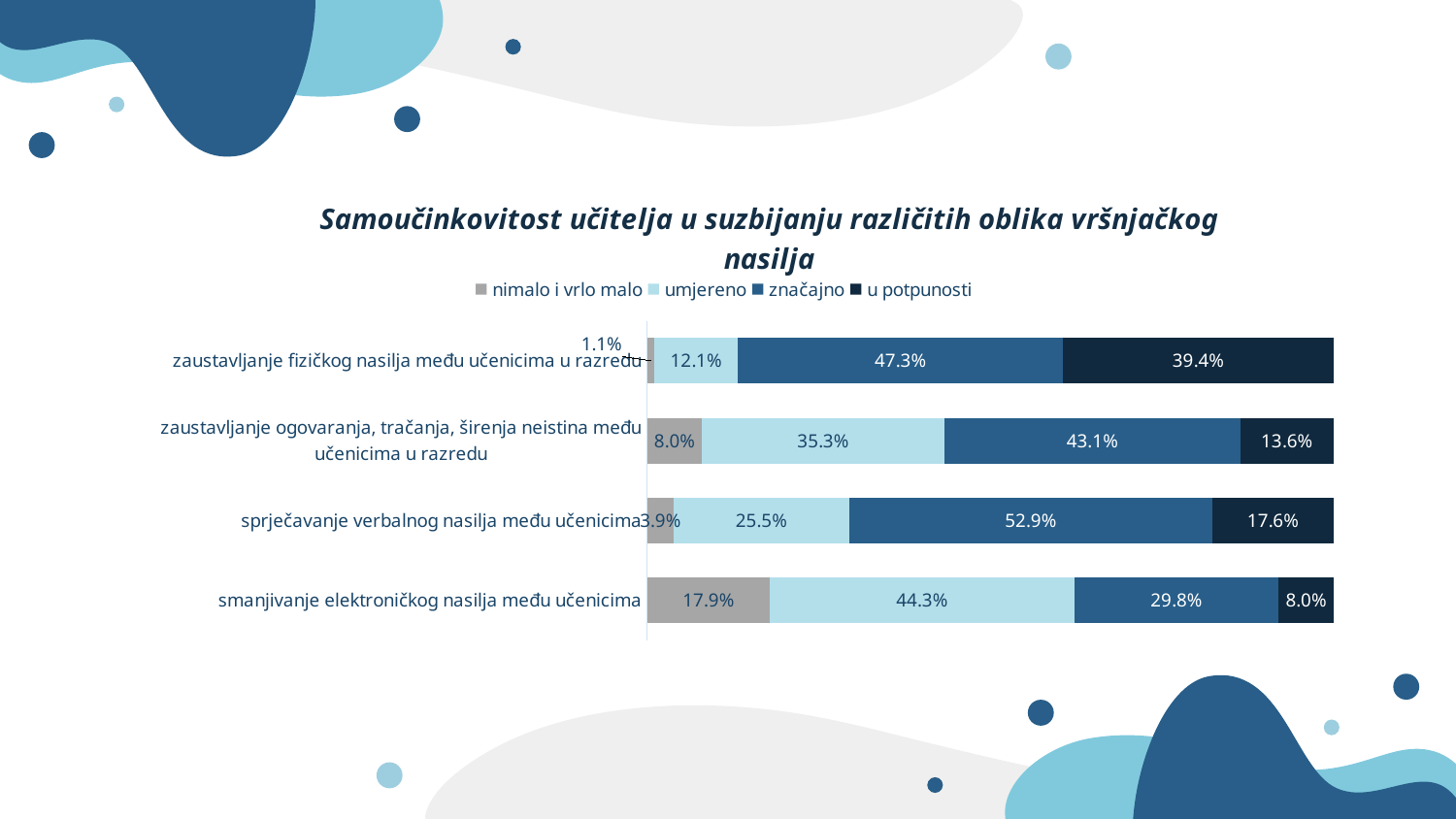
How many categories are plotted on the chart? 4 How many series does the legend list? 4 Which category has the highest 'značajno' value? sprječavanje verbalnog nasilja među učenicima What type of chart is shown on the slide? stacked bar chart Which category has the lowest 'u potpunosti' value? smanjivanje elektroničkog nasilja među učenicima What is the 'u potpunosti' value for 'zaustavljanje fizičkog nasilja među učenicima u razredu'? 39.4% What is the 'značajno' value for 'sprječavanje verbalnog nasilja među učenicima'? 52.9% Which is larger: the 'umjereno' value for 'zaustavljanje ogovaranja, tračanja, širenja neistina među učenicima u razredu' or for 'sprječavanje verbalnog nasilja među učenicima'? zaustavljanje ogovaranja, tračanja, širenja neistina među učenicima u razredu What is the difference between the 'u potpunosti' values for 'zaustavljanje fizičkog nasilja među učenicima u razredu' and 'sprječavanje verbalnog nasilja među učenicima'? 21.8% What is the 'umjereno' value for 'smanjivanje elektroničkog nasilja među učenicima'? 44.3% What is the title of the chart? Samoučinkovitost učitelja u suzbijanju različitih oblika vršnjačkog nasilja What is the 'nimalo i vrlo malo' value for 'zaustavljanje ogovaranja, tračanja, širenja neistina među učenicima u razredu'? 8.0%